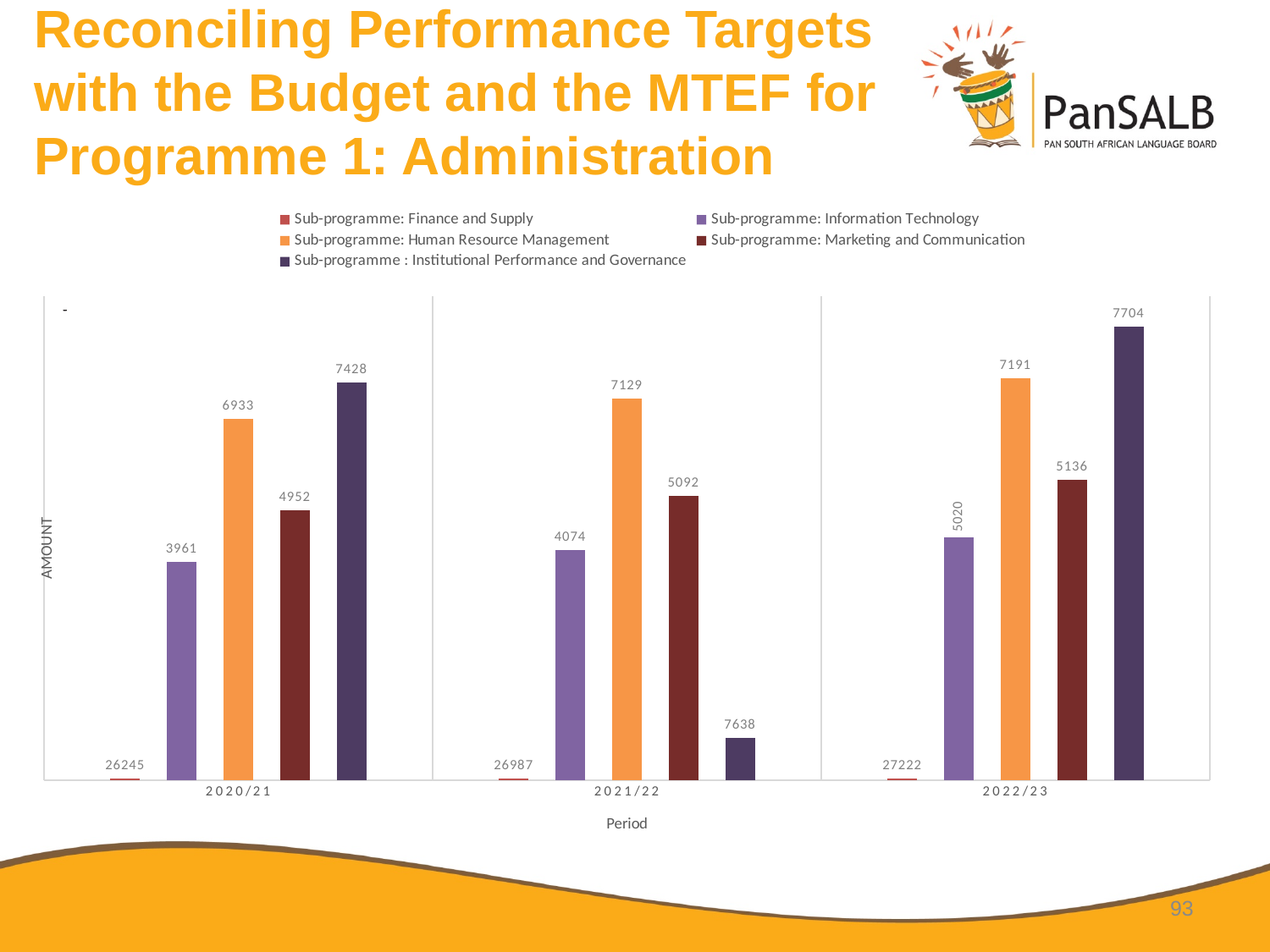
What is the difference between the Sub-programme: Marketing and Communication values for 2021/22 and 2020/21? 140 How many series does the legend list? 5 What is the value for Sub-programme: Human Resource Management in 2020/21? 6933 What is the value for Sub-programme: Information Technology in 2022/23? 5020 Do the values for Sub-programme: Information Technology rise or fall from 2020/21 to 2022/23? rise What is the title of the horizontal axis? Period Which is larger according to the data labels: Sub-programme: Human Resource Management in 2021/22 or Sub-programme: Institutional Performance and Governance in 2021/22? Sub-programme: Institutional Performance and Governance What is the title of the vertical axis? AMOUNT What is the value for Sub-programme: Finance and Supply in 2021/22? 26987 What type of chart is shown on the slide? bar chart What is the value for Sub-programme: Institutional Performance and Governance in 2022/23? 7704 How many periods are shown on the x axis? 3